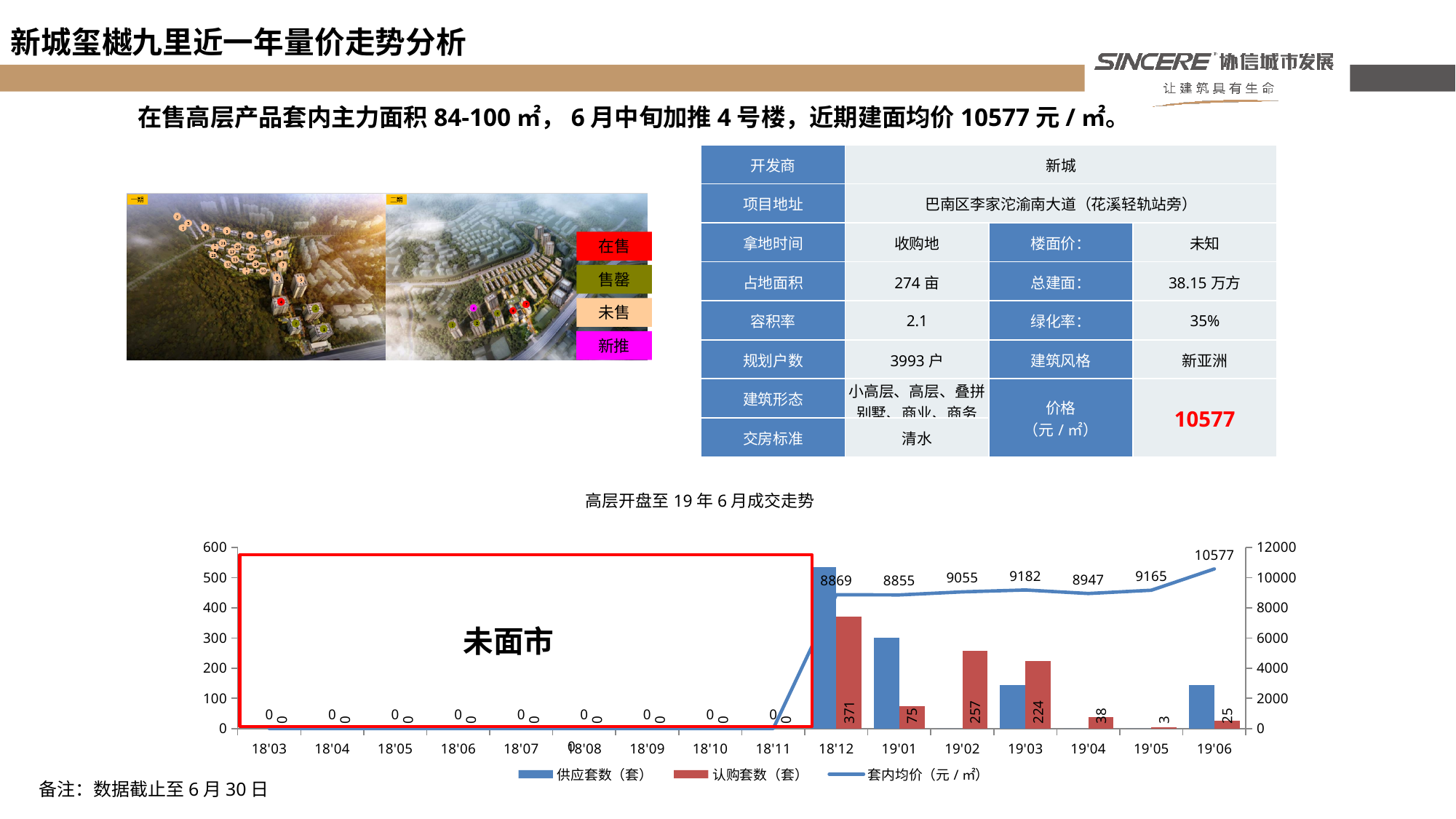
What is the 认购套数 value for 18'12? 371 Is the 供应套数 value for 18'12 greater or less than 500? greater Which month has the highest 套内均价? 19'06 What is the difference between the 认购套数 for 19'02 and 19'03? 33 How many months are shown on the x axis of the chart? 16 What is the 套内均价 value for 19'03? 9182 Which month has the highest 认购套数? 18'12 What is the 套内均价 value for 19'06? 10577 What is the title of the chart at the bottom of the slide? 高层开盘至19年6月成交走势 What is the 认购套数 value for 19'05? 3 How many series does the chart legend list? 3 Is the 认购套数 for 19'02 greater than that for 19'04? Yes